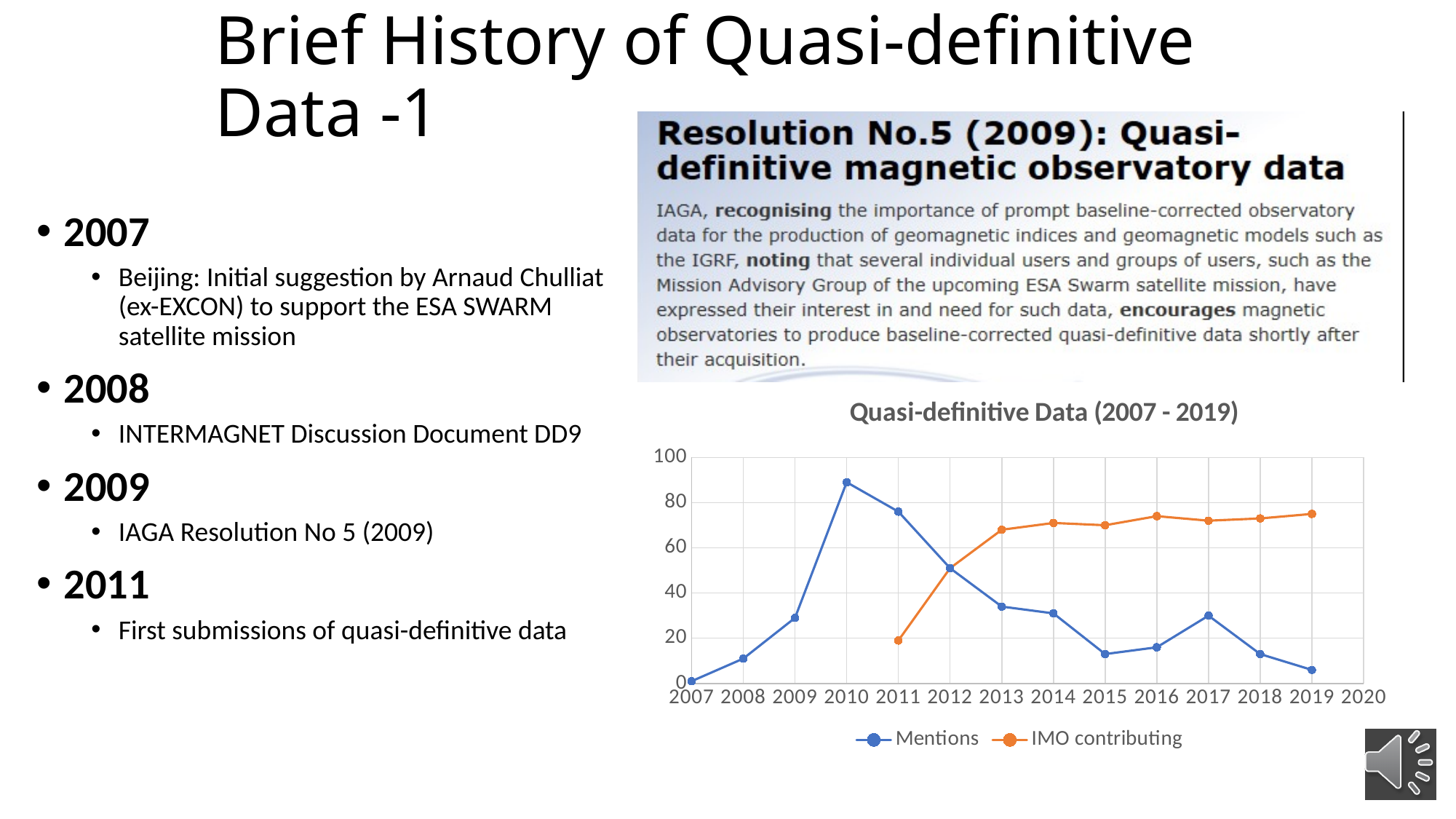
What kind of chart is shown on the slide? Line chart In which year does the Mentions series reach its highest value? 2010 Is the value for IMO contributing in 2019 greater or less than 60? greater Which series has the higher value in 2010, Mentions or IMO contributing? Mentions What is the title of the chart? Quasi-definitive Data (2007 - 2019) Does the IMO contributing series rise or fall between 2011 and 2013? Rise Which series has the higher value in 2017, Mentions or IMO contributing? IMO contributing Does the Mentions series rise or fall between 2010 and 2015? Fall Is the value for Mentions in 2010 greater or less than 80? greater How many series does the chart legend list? 2 In which year is the first data point of the IMO contributing series plotted? 2011